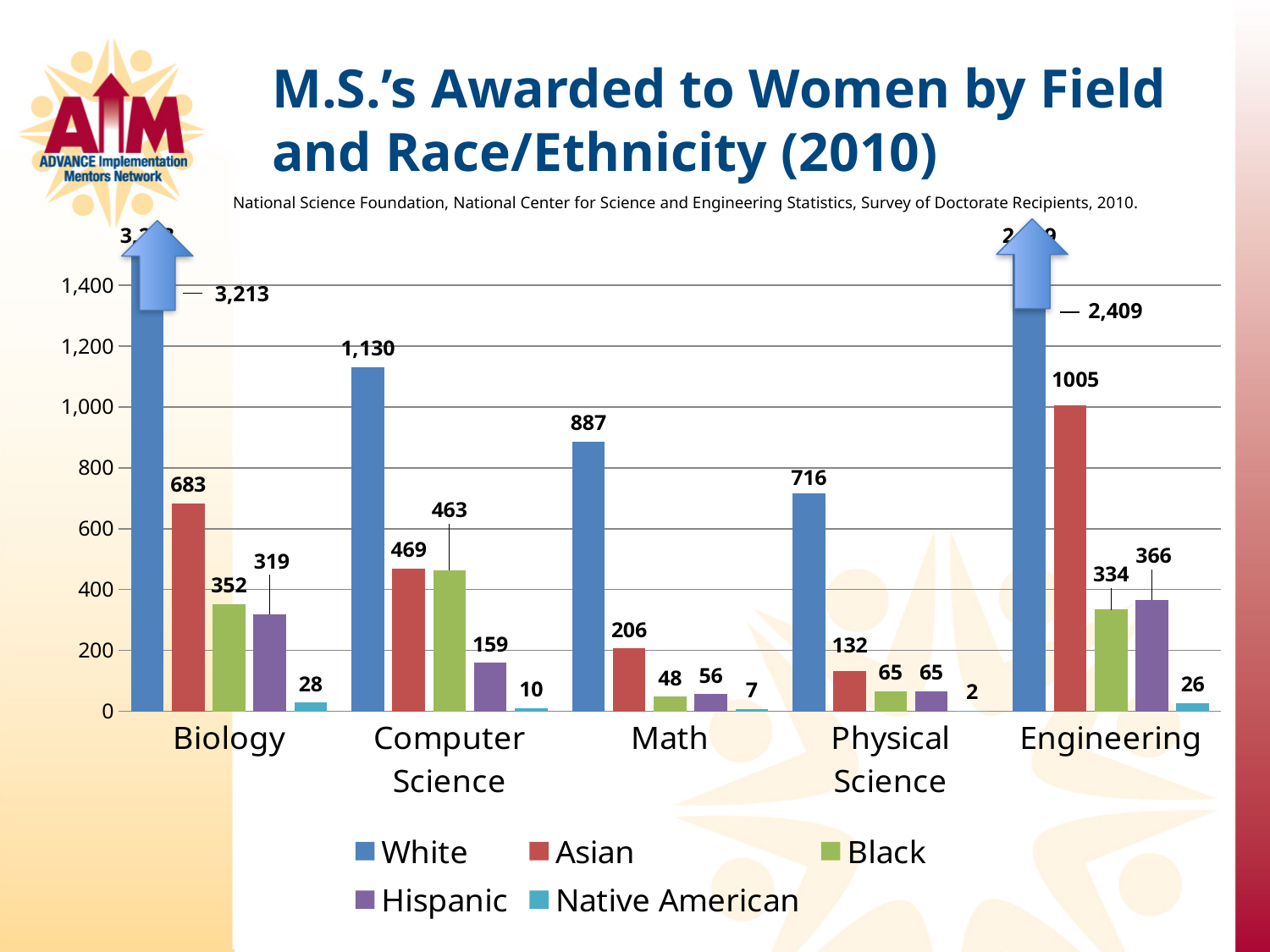
What is the value for Asian in Engineering? 1005 What is the value for White in Computer Science? 1,130 Which field has the highest value for White? Biology How many series does the legend list? 5 Which is larger in Engineering, the Black value or the Hispanic value? Hispanic What is the title of the chart? M.S.'s Awarded to Women by Field and Race/Ethnicity (2010) Which field has the lowest value for Native American? Physical Science What is the value for Native American in Physical Science? 2 What kind of chart is shown on the slide? bar chart How many fields are shown on the x axis? 5 What is the difference between the White and Asian values in Math? 681 What is the value for Hispanic in Biology? 319